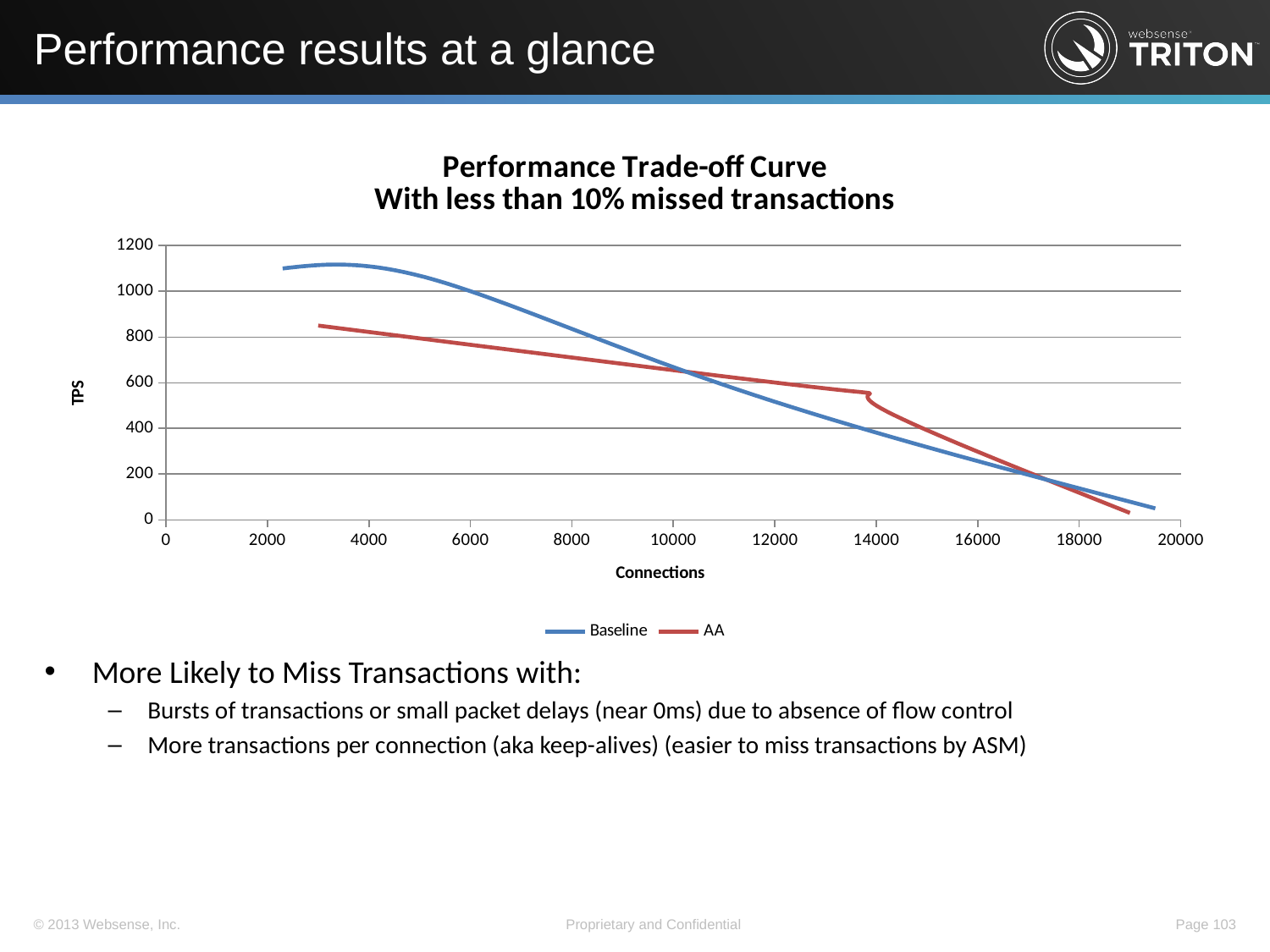
What kind of chart is shown on the slide? line chart How many series does the legend list? 2 Is the AA TPS value at 12000 connections greater or less than 400? greater Does the AA series rise or fall as Connections increase? fall What is the label of the x axis? Connections Is the Baseline TPS value at 14000 connections greater or less than 600? less At 14000 connections, which series has the higher TPS, Baseline or AA? AA Does the Baseline series rise or fall as Connections increase? fall Is the Baseline TPS value at 4000 connections greater or less than 1000? greater What are the names of the two series in the legend? Baseline and AA At 4000 connections, which series has the higher TPS, Baseline or AA? Baseline